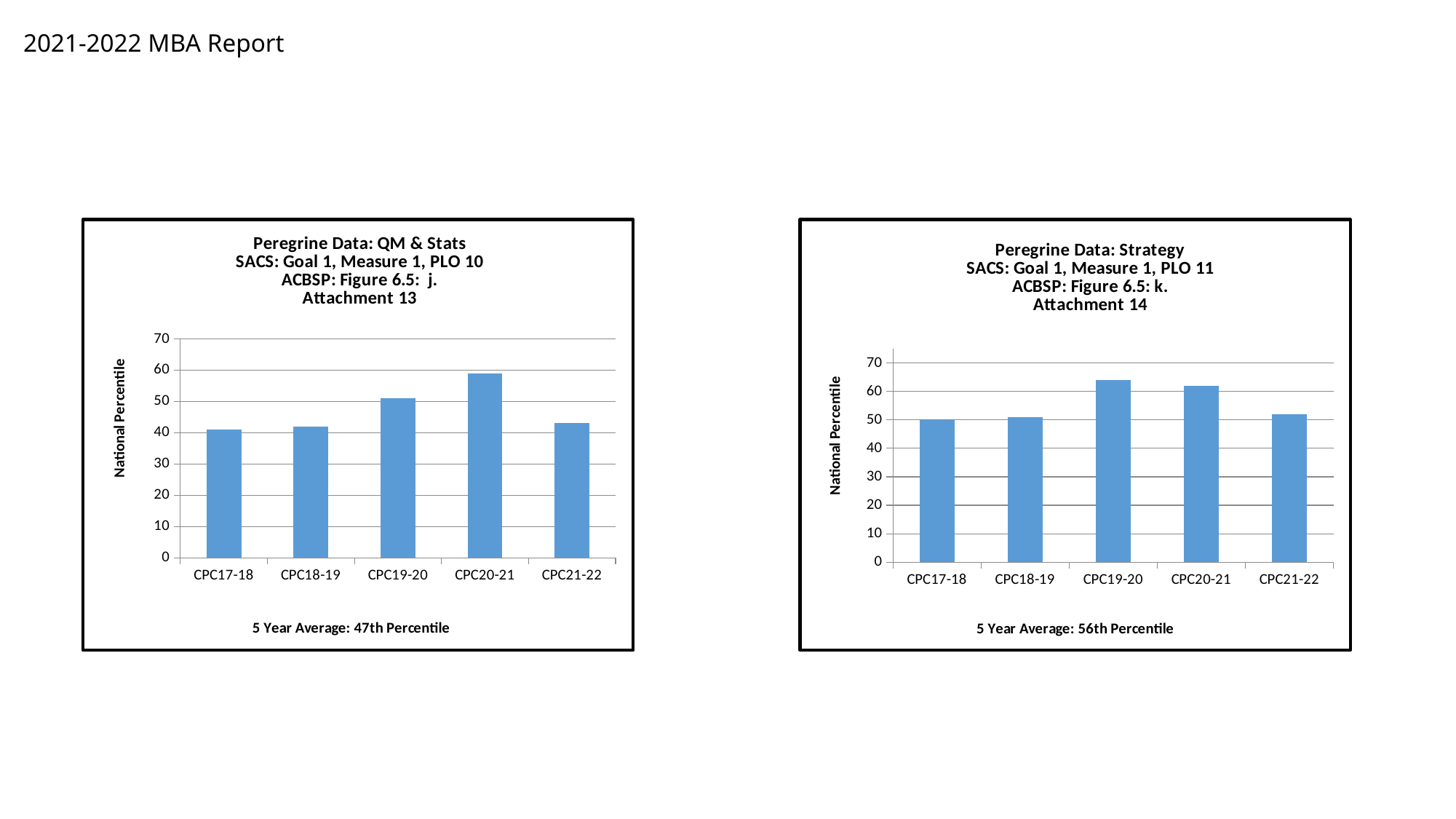
In the 'Peregrine Data: Strategy' chart on the right, is the value for CPC19-20 greater or less than 60? greater In the 'Peregrine Data: QM & Stats' chart on the left, which is larger, the value for CPC19-20 or the value for CPC21-22? CPC19-20 What is the y-axis label of the 'Peregrine Data: Strategy' chart on the right? National Percentile In the 'Peregrine Data: QM & Stats' chart on the left, is the value for CPC17-18 greater or less than 50? less How many categories are shown on the x axis of the 'Peregrine Data: Strategy' chart on the right? 5 In the 'Peregrine Data: Strategy' chart on the right, which is larger, the value for CPC19-20 or the value for CPC17-18? CPC19-20 In the 'Peregrine Data: Strategy' chart on the right, is the value for CPC21-22 greater or less than 60? less In the 'Peregrine Data: Strategy' chart on the right, which is larger, the value for CPC20-21 or the value for CPC18-19? CPC20-21 What kind of chart is the 'Peregrine Data: QM & Stats' chart on the left? bar chart In the 'Peregrine Data: QM & Stats' chart on the left, which category has the highest value? CPC20-21 What 5 year average is stated below the 'Peregrine Data: QM & Stats' chart on the left? 47th Percentile